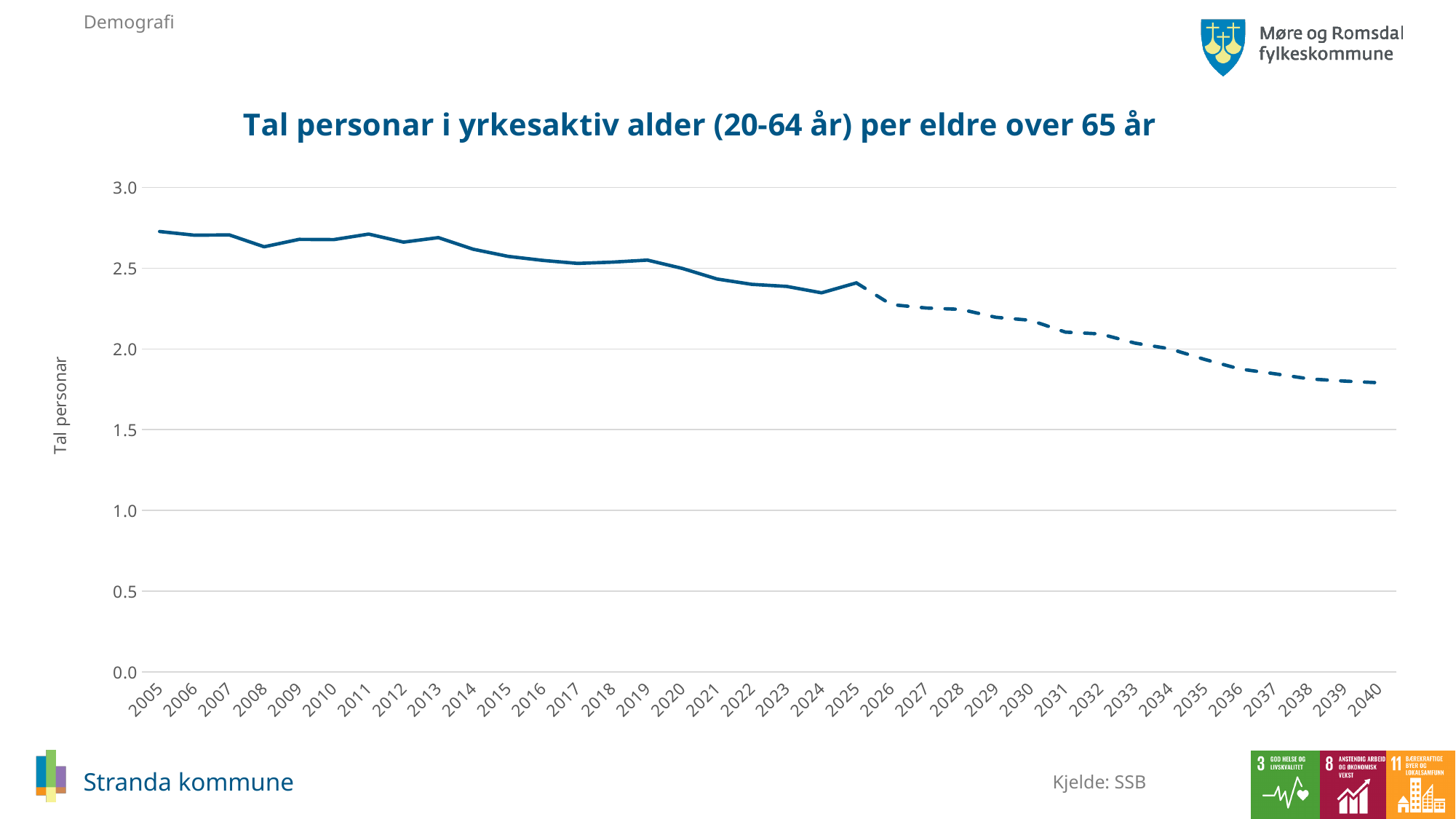
Is the value for 2010 greater or less than 2.5? greater Is the value for 2005 greater or less than 2.5? greater Do the values generally rise or fall from 2005 to 2040? fall What kind of chart is shown on the slide? line chart Is the value for 2040 greater or less than 2.0? less Which year has the larger value, 2015 or 2030? 2015 How many years are shown along the x axis of the chart? 36 What is the title of the chart? Tal personar i yrkesaktiv alder (20-64 år) per eldre over 65 år Which year has the larger value, 2005 or 2040? 2005 What is the label on the vertical axis of the chart? Tal personar